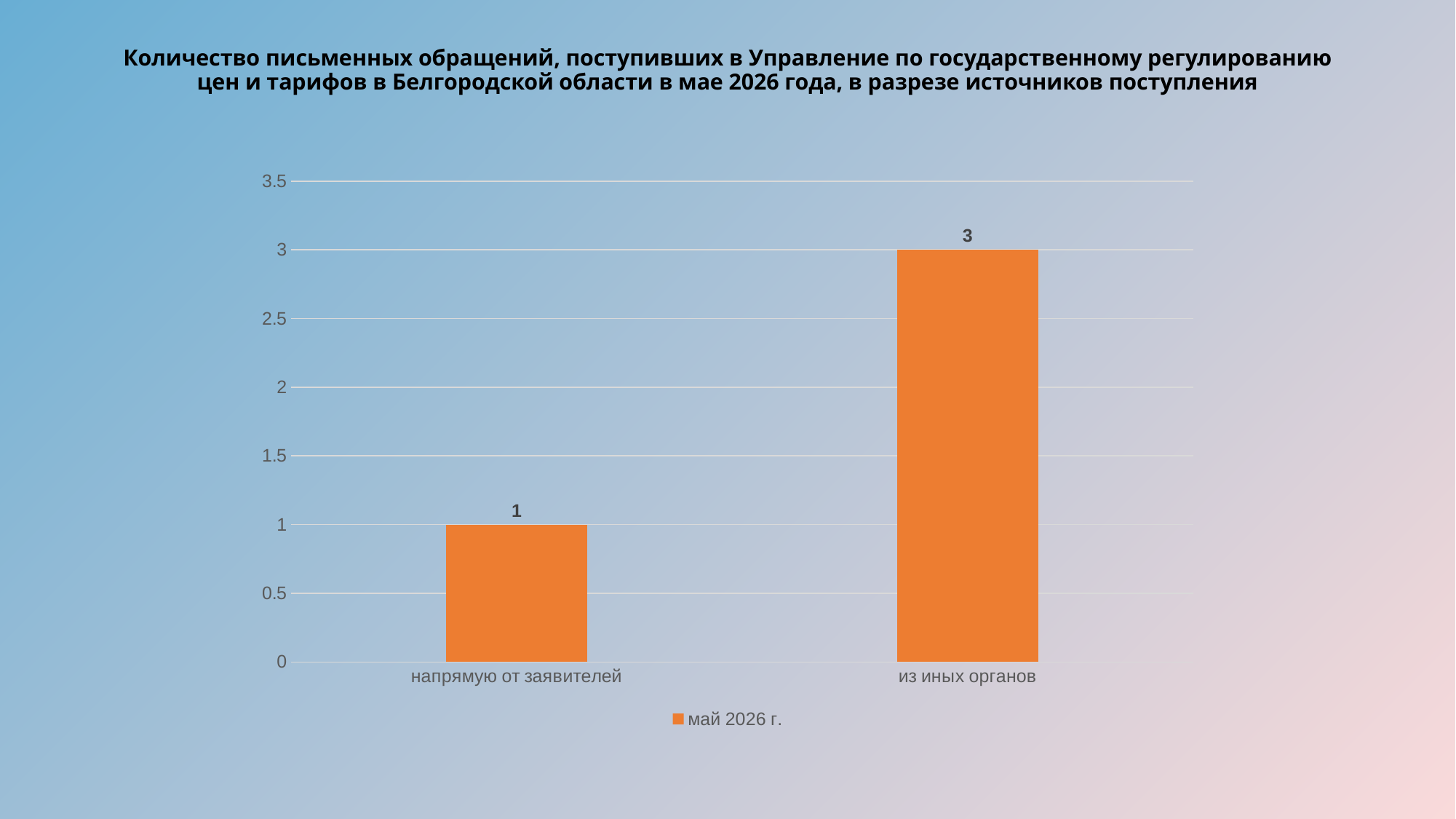
How many series does the legend list? 1 What is the difference between the values for "из иных органов" and "напрямую от заявителей"? 2 Which category has the lowest value? напрямую от заявителей How many categories are shown on the x axis? 2 Is the value for "из иных органов" greater or less than 2? greater What is the value for "из иных органов"? 3 What is the value for "напрямую от заявителей"? 1 What kind of chart is shown on the slide? bar chart Which is larger: the value for "напрямую от заявителей" or the value for "из иных органов"? из иных органов Is the value for "напрямую от заявителей" greater or less than 1.5? less Which category has the highest value? из иных органов What is the legend entry for the series shown? май 2026 г.